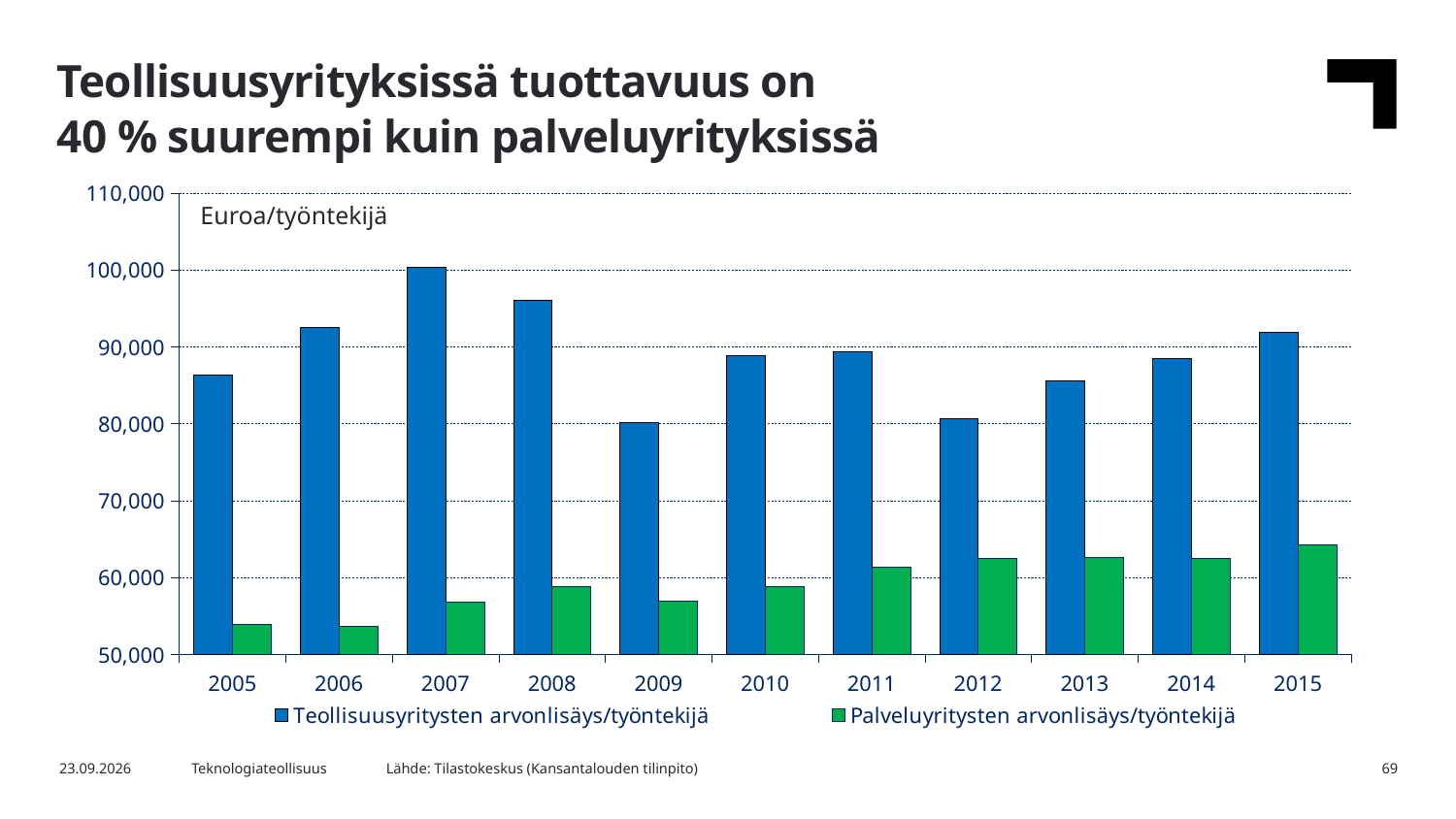
How many years are shown on the x axis? 11 Is the value for Teollisuusyritysten arvonlisäys/työntekijä in 2009 greater or less than 90,000? less Is the value for Teollisuusyritysten arvonlisäys/työntekijä in 2008 greater or less than 90,000? greater Which year has the larger value for Teollisuusyritysten arvonlisäys/työntekijä, 2005 or 2006? 2006 What unit label is shown inside the chart area at the top left? Euroa/työntekijä In which year is the value for Teollisuusyritysten arvonlisäys/työntekijä highest? 2007 In which year is the value for Palveluyritysten arvonlisäys/työntekijä highest? 2015 Does the value for Palveluyritysten arvonlisäys/työntekijä generally rise or fall from 2005 to 2015? Rise What kind of chart is shown on the slide? Bar chart Is the value for Palveluyritysten arvonlisäys/työntekijä in 2015 greater or less than 60,000? greater How many series does the legend list? 2